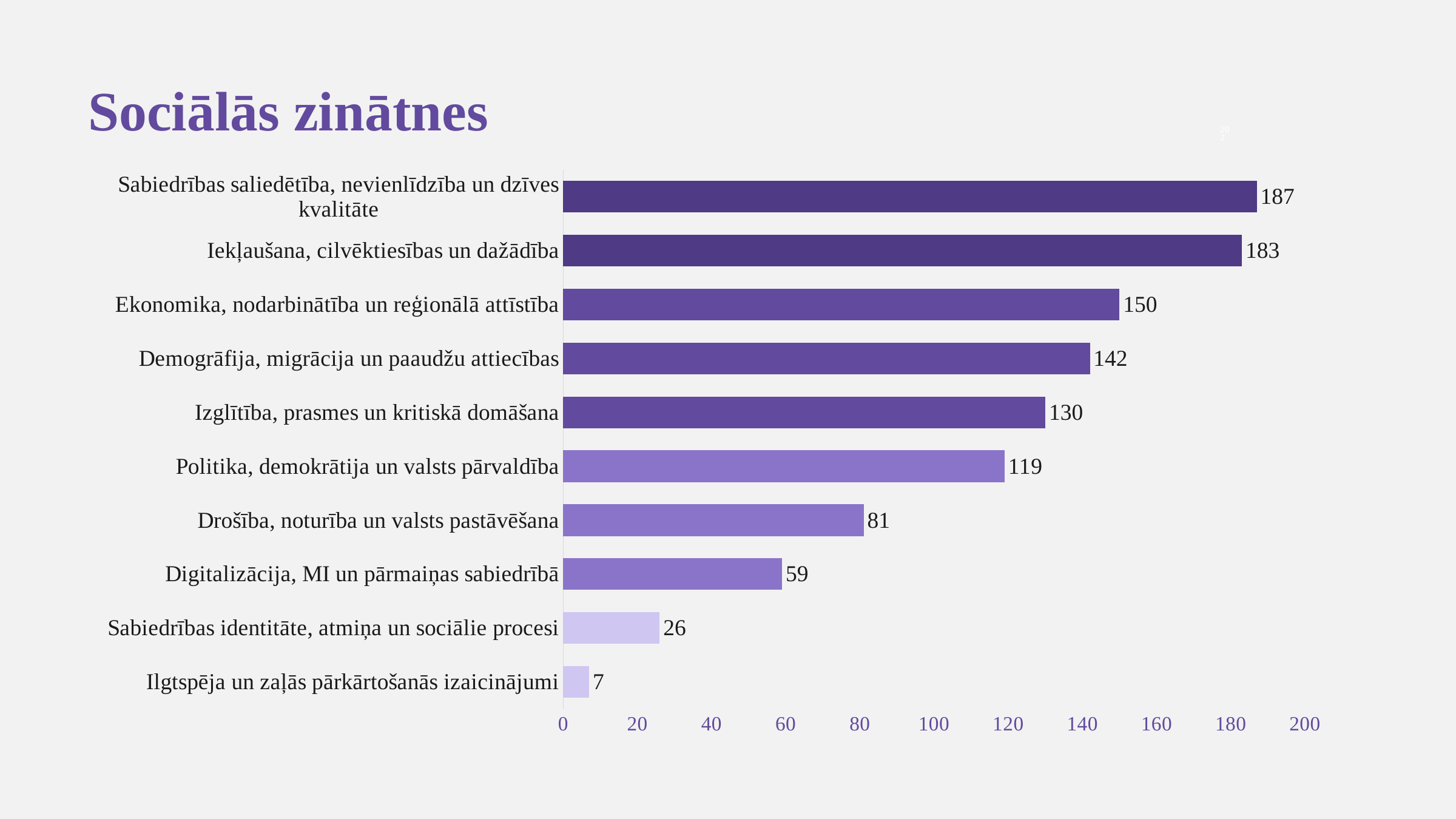
Is the value for "Politika, demokrātija un valsts pārvaldība" greater or less than 100? greater What is the difference between the values for "Politika, demokrātija un valsts pārvaldība" and "Sabiedrības identitāte, atmiņa un sociālie procesi"? 93 What is the value for "Ekonomika, nodarbinātība un reģionālā attīstība"? 150 Which category has the highest value? Sabiedrības saliedētība, nevienlīdzība un dzīves kvalitāte What is the title of the slide? Sociālās zinātnes Which is larger: the value for "Demogrāfija, migrācija un paaudžu attiecības" or the value for "Izglītība, prasmes un kritiskā domāšana"? Demogrāfija, migrācija un paaudžu attiecības What is the value for "Drošība, noturība un valsts pastāvēšana"? 81 What is the value for "Digitalizācija, MI un pārmaiņas sabiedrībā"? 59 Which category has the lowest value? Ilgtspēja un zaļās pārkārtošanās izaicinājumi What kind of chart is shown on the slide? Bar chart What is the difference between the values for "Sabiedrības saliedētība, nevienlīdzība un dzīves kvalitāte" and "Iekļaušana, cilvēktiesības un dažādība"? 4 How many categories are shown in the chart? 10